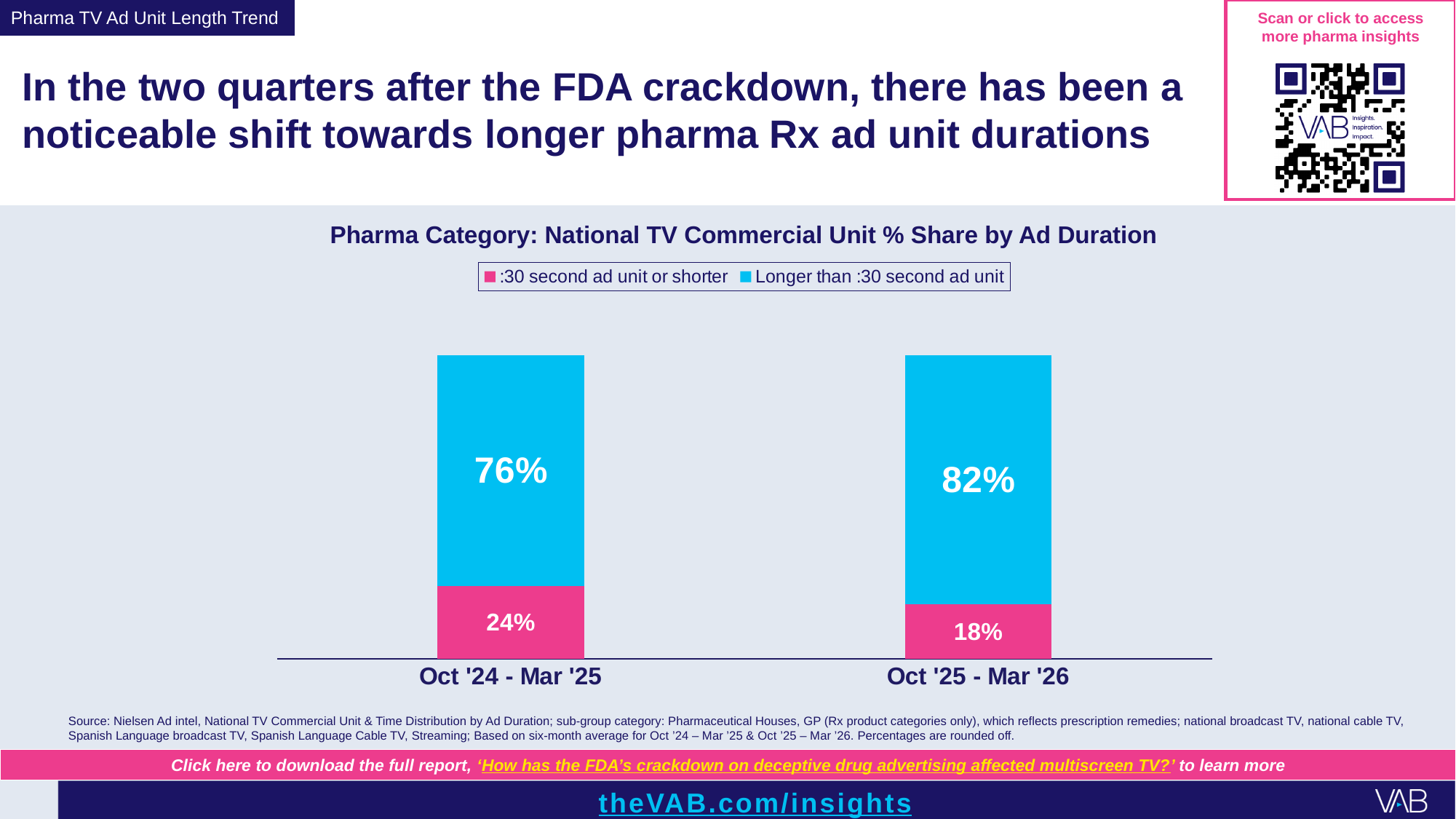
What is the share of 'Longer than :30 second ad unit' for Oct '25 - Mar '26? 82% Which period has the higher share of 'Longer than :30 second ad unit'? Oct '25 - Mar '26 What is the share of 'Longer than :30 second ad unit' for Oct '24 - Mar '25? 76% What is the share of ':30 second ad unit or shorter' for Oct '24 - Mar '25? 24% Is the ':30 second ad unit or shorter' share larger in Oct '24 - Mar '25 or Oct '25 - Mar '26? Oct '24 - Mar '25 How many series does the legend list? 2 Which period has the lower share of ':30 second ad unit or shorter'? Oct '25 - Mar '26 What is the title of the chart? Pharma Category: National TV Commercial Unit % Share by Ad Duration What is the share of ':30 second ad unit or shorter' for Oct '25 - Mar '26? 18% What kind of chart is shown on the slide? Stacked bar chart How many time periods are shown on the x axis? 2 By how many percentage points did the 'Longer than :30 second ad unit' share change from Oct '24 - Mar '25 to Oct '25 - Mar '26? 6 percentage points